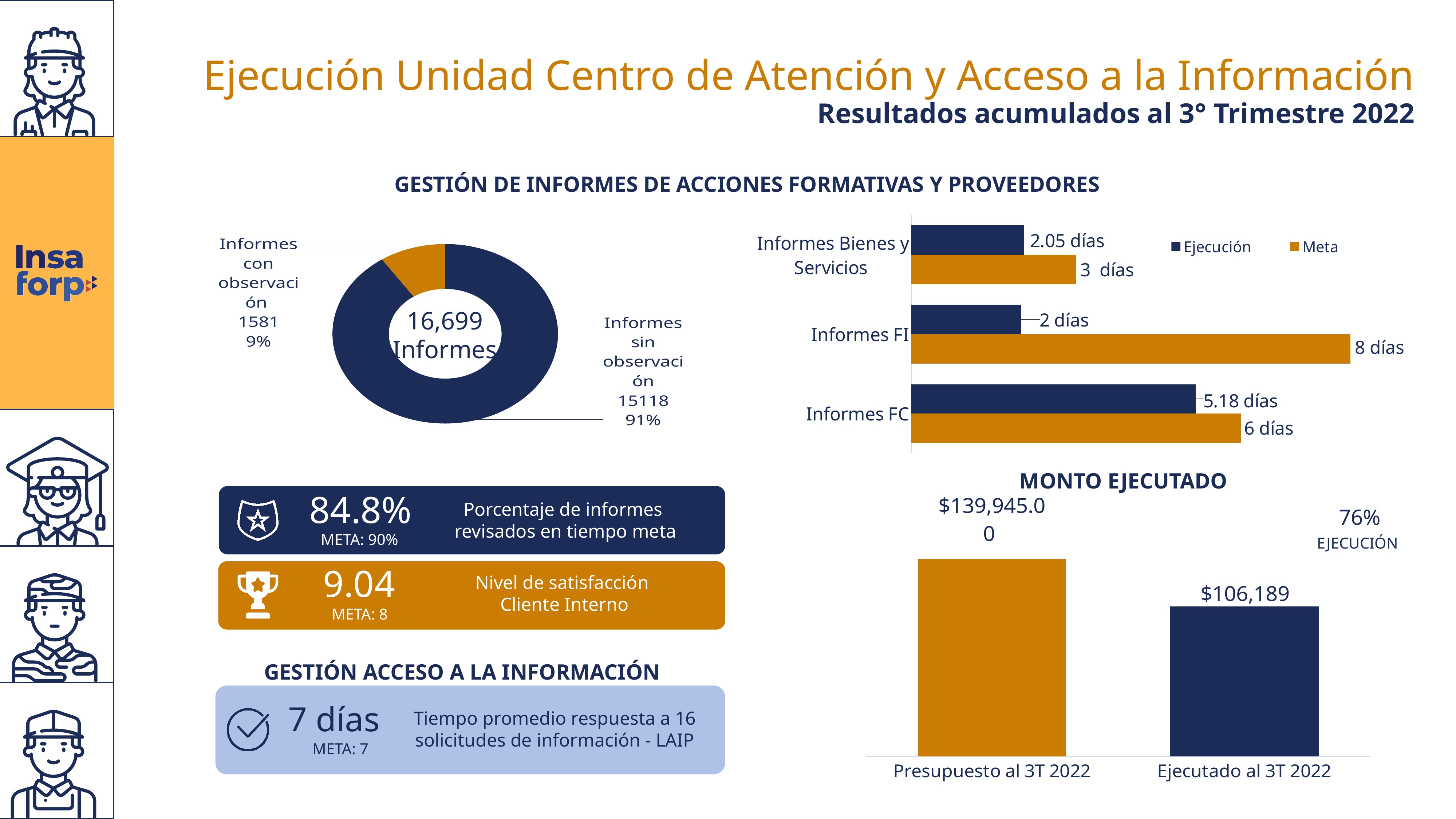
How many series does the legend of the Ejecución vs Meta bar chart list? 2 In the Ejecución vs Meta bar chart, what is the difference between the Meta and Ejecución values for Informes FI? 6 días In the Ejecución vs Meta bar chart, which category has the highest Meta value? Informes FI In the donut chart, how many Informes con observación are there? 1581 In the donut chart, what share of the total do Informes sin observación represent? 91% In the Ejecución vs Meta bar chart, what is the Meta value for Informes FI? 8 días What kind of chart is the one showing Informes con observación and Informes sin observación? doughnut chart In the MONTO EJECUTADO chart, what is the value for Presupuesto al 3T 2022? $139,945.00 In the MONTO EJECUTADO chart, what is the difference between Presupuesto al 3T 2022 and Ejecutado al 3T 2022? $33,756 What total number of Informes is shown in the centre of the donut chart? 16,699 Informes In the Ejecución vs Meta bar chart, which has the larger Ejecución value: Informes Bienes y Servicios or Informes FC? Informes FC In the Ejecución vs Meta bar chart, what is the Ejecución value for Informes FC? 5.18 días